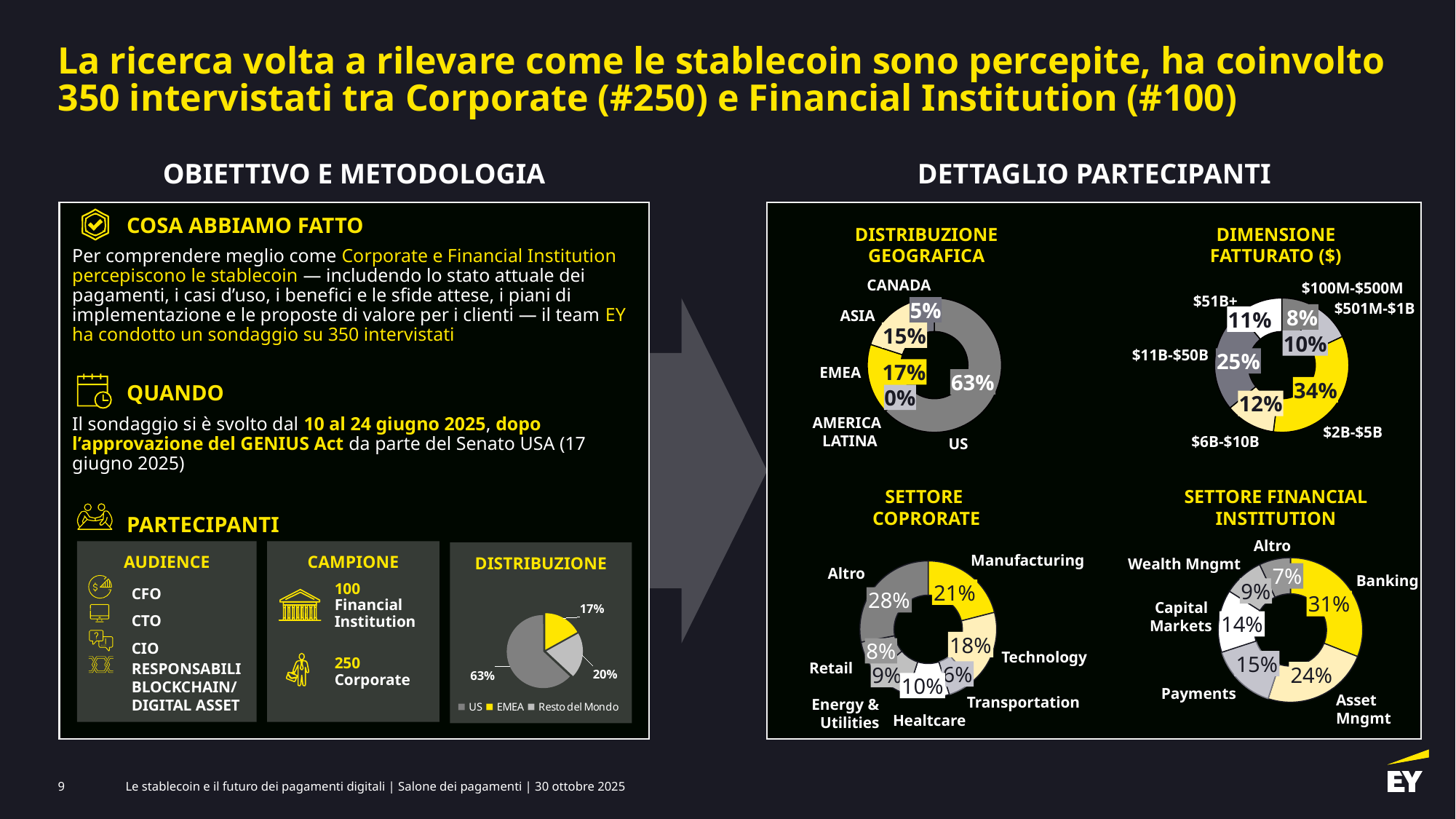
In the SETTORE COPRORATE chart, which sector has the smallest share? Transportation In the SETTORE COPRORATE chart, which is larger: Retail or Healtcare? Healtcare In the SETTORE FINANCIAL INSTITUTION chart, what is the difference between Banking and Payments? 16% In the DISTRIBUZIONE GEOGRAFICA chart, what percentage of participants are from the US? 63% In the DISTRIBUZIONE GEOGRAFICA chart, which region has the lowest share? AMERICA LATINA In the DIMENSIONE FATTURATO ($) chart, how many revenue bands are shown? 6 In the DIMENSIONE FATTURATO ($) chart, what is the share for $11B-$50B? 25% In the DIMENSIONE FATTURATO ($) chart, which revenue band has the largest share? $2B-$5B In the DISTRIBUZIONE GEOGRAFICA chart, what is the difference between the ASIA and CANADA shares? 10% In the small DISTRIBUZIONE pie chart in the PARTECIPANTI section, what share is labelled for EMEA? 17% In the SETTORE COPRORATE chart, what is the share for Technology? 18% In the SETTORE FINANCIAL INSTITUTION chart, what is the share for Asset Mngmt? 24%